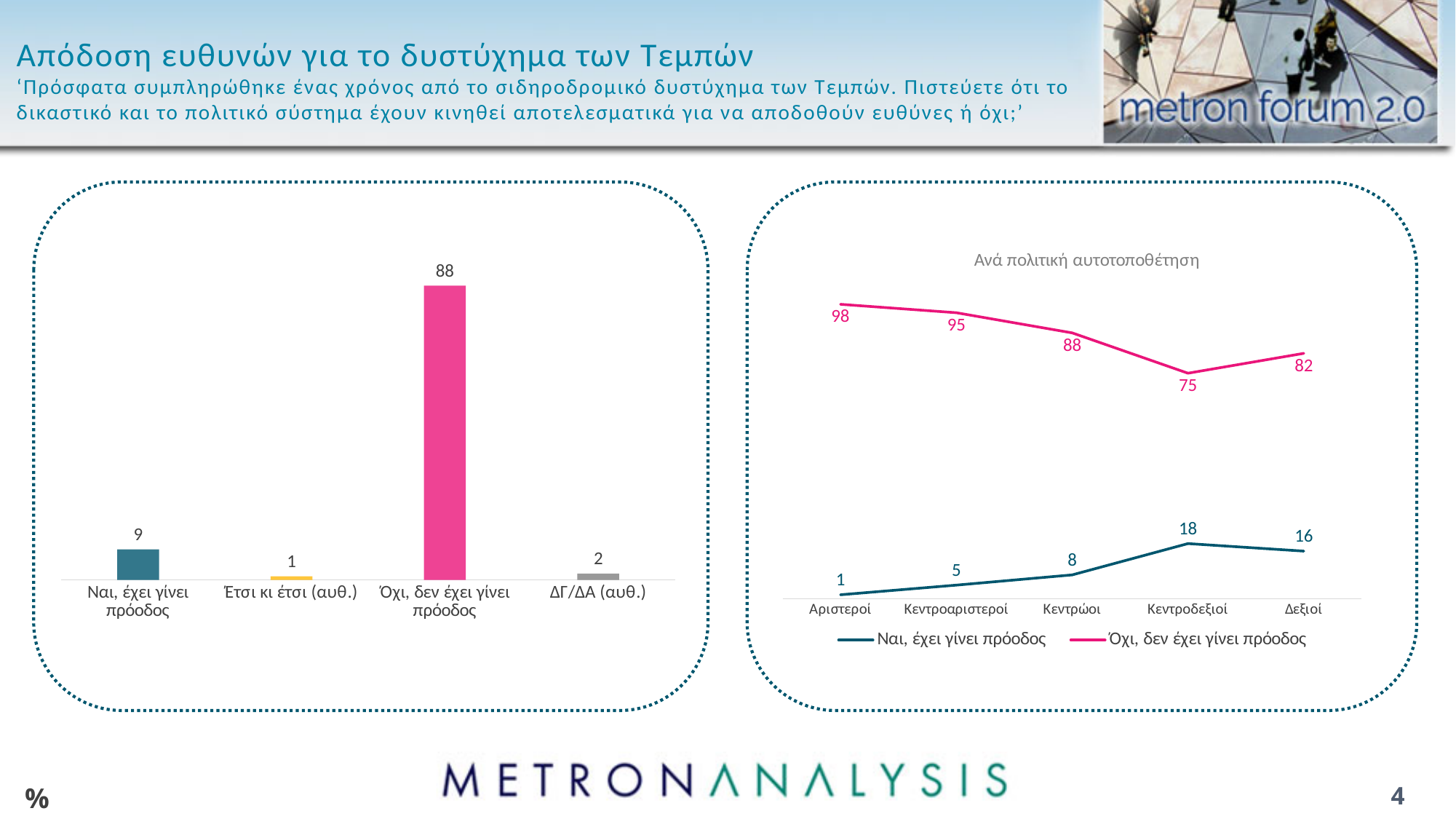
In the bar chart on the left, what is the value for 'Όχι, δεν έχει γίνει πρόοδος'? 88 What kind of chart is the chart on the left? bar chart In the line chart 'Ανά πολιτική αυτοτοποθέτηση', which is larger for Δεξιοί: 'Ναι, έχει γίνει πρόοδος' or 'Όχι, δεν έχει γίνει πρόοδος'? Όχι, δεν έχει γίνει πρόοδος In the bar chart on the left, how many categories are shown? 4 In the line chart 'Ανά πολιτική αυτοτοποθέτηση', how many series does the legend list? 2 In the line chart 'Ανά πολιτική αυτοτοποθέτηση', does the 'Ναι, έχει γίνει πρόοδος' line rise or fall from Αριστεροί to Κεντροδεξιοί? rise In the bar chart on the left, which category has the lowest value? Έτσι κι έτσι (αυθ.) In the line chart 'Ανά πολιτική αυτοτοποθέτηση', what is the difference between 'Όχι, δεν έχει γίνει πρόοδος' for Αριστεροί and for Κεντρώοι? 10 In the line chart 'Ανά πολιτική αυτοτοποθέτηση', what is the value of 'Ναι, έχει γίνει πρόοδος' for Αριστεροί? 1 In the line chart 'Ανά πολιτική αυτοτοποθέτηση', what is the value of 'Όχι, δεν έχει γίνει πρόοδος' for Κεντροδεξιοί? 75 In the line chart 'Ανά πολιτική αυτοτοποθέτηση', which group has the highest value for 'Ναι, έχει γίνει πρόοδος'? Κεντροδεξιοί In the bar chart on the left, what is the difference between 'Όχι, δεν έχει γίνει πρόοδος' and 'Ναι, έχει γίνει πρόοδος'? 79